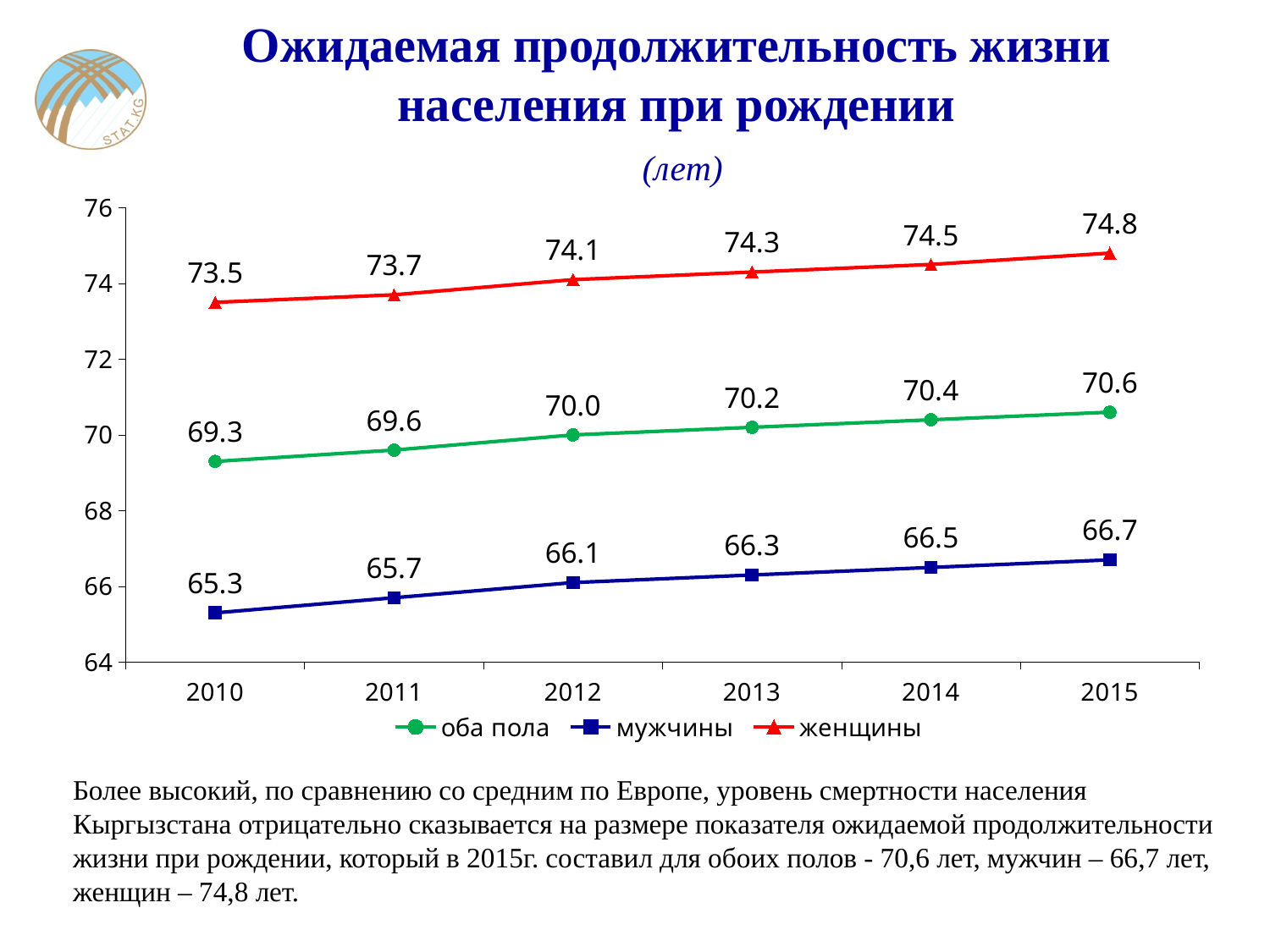
What is the difference between the женщины and мужчины values in 2015? 8.1 How many series does the legend list? 3 Do the values for женщины rise or fall from 2010 to 2015? rise Is the value for мужчины in 2014 greater or less than 68? less How many years are shown on the x axis? 6 Which is larger in 2013: the value for женщины or the value for оба пола? женщины In which year is the value for оба пола highest? 2015 In which year is the value for мужчины lowest? 2010 What is the value for оба пола in 2012? 70.0 What kind of chart is this? line chart What is the value for женщины in 2015? 74.8 What is the value for мужчины in 2010? 65.3